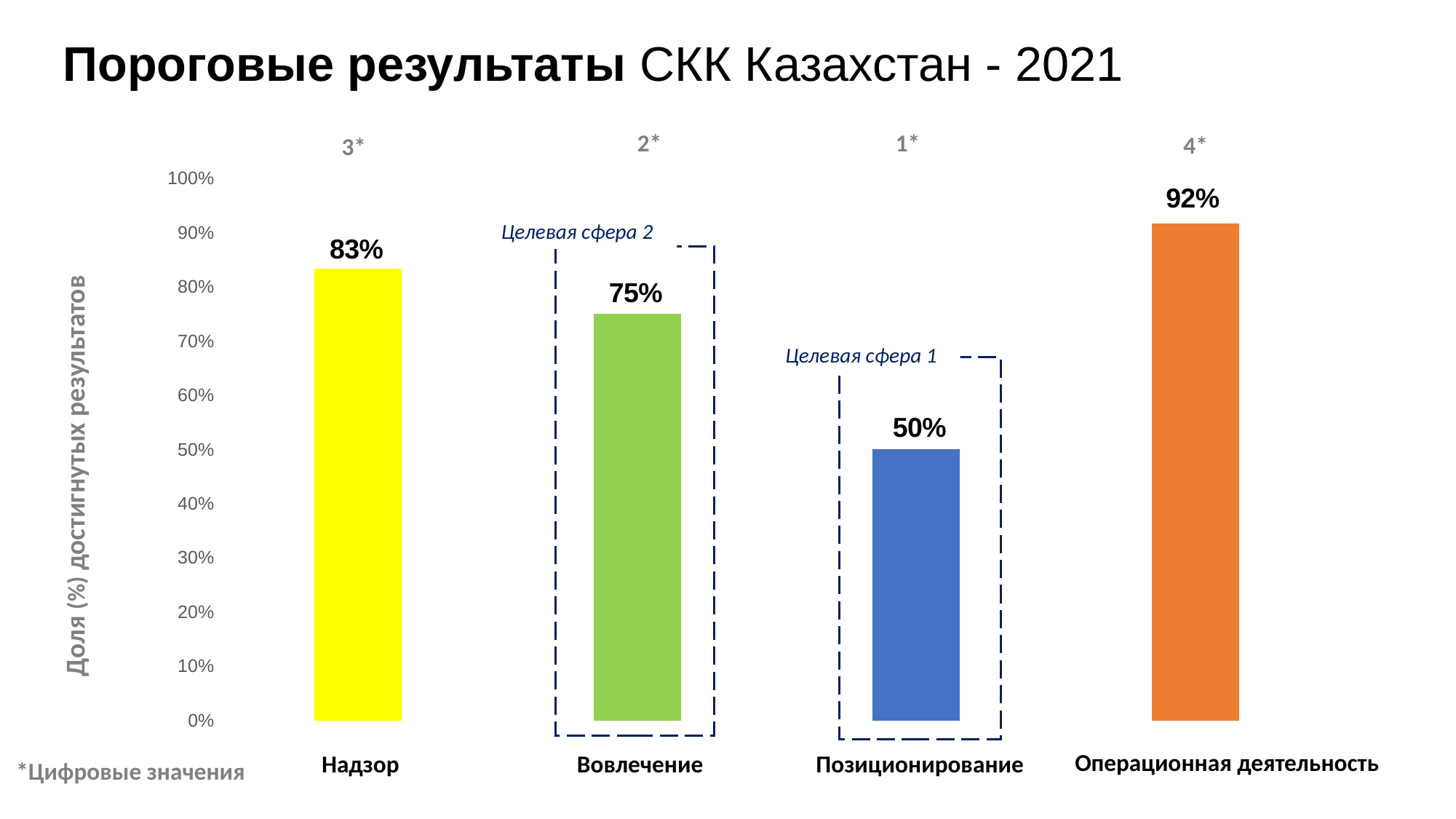
How many categories are shown in the chart? 4 What is the difference between the values for Надзор and Вовлечение? 8% Which category has the lowest value? Позиционирование Which category has the highest value? Операционная деятельность What is the value for Операционная деятельность? 92% What is the value for Вовлечение? 75% Which is larger, the value for Надзор or the value for Вовлечение? Надзор What is the difference between the values for Операционная деятельность and Позиционирование? 42% What is the value for Позиционирование? 50% What kind of chart is shown on the slide? Bar chart What is the value for Надзор? 83% What is the label of the vertical axis? Доля (%) достигнутых результатов